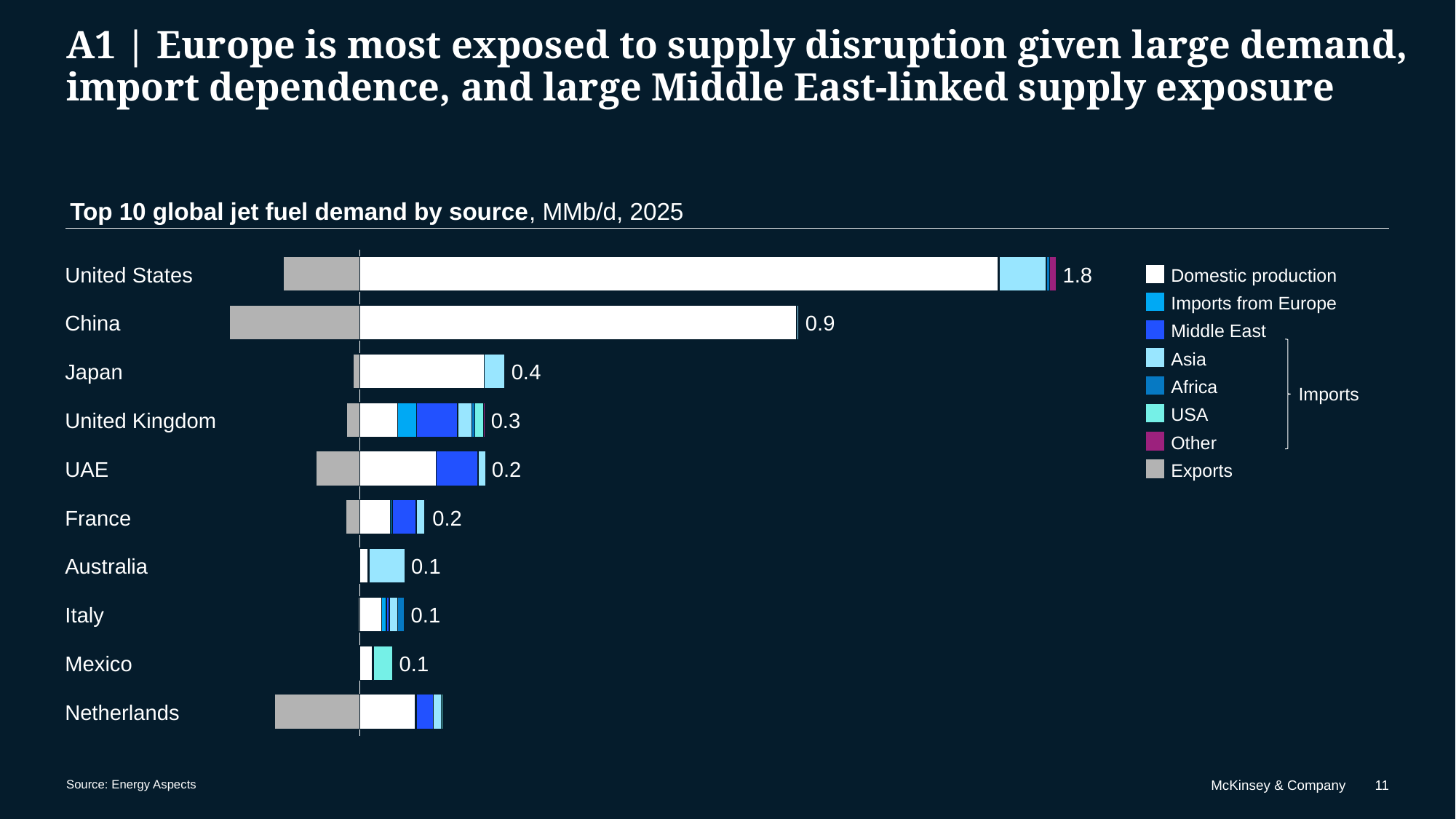
What is the difference between the labelled values for the United States and China? 0.9 What is the unit of measurement given in the chart title? MMb/d What value is labelled for China? 0.9 Which legend entry is shown in grey? Exports Which has a larger labelled value, Japan or the United Kingdom? Japan How many entries does the legend list? 8 What value is labelled for Japan? 0.4 Which country has the highest labelled jet fuel demand? United States What kind of chart is shown on the slide? Stacked bar chart What is the total jet fuel demand value shown for the United States? 1.8 How many countries are listed on the chart? 10 What value is labelled for the United Kingdom? 0.3